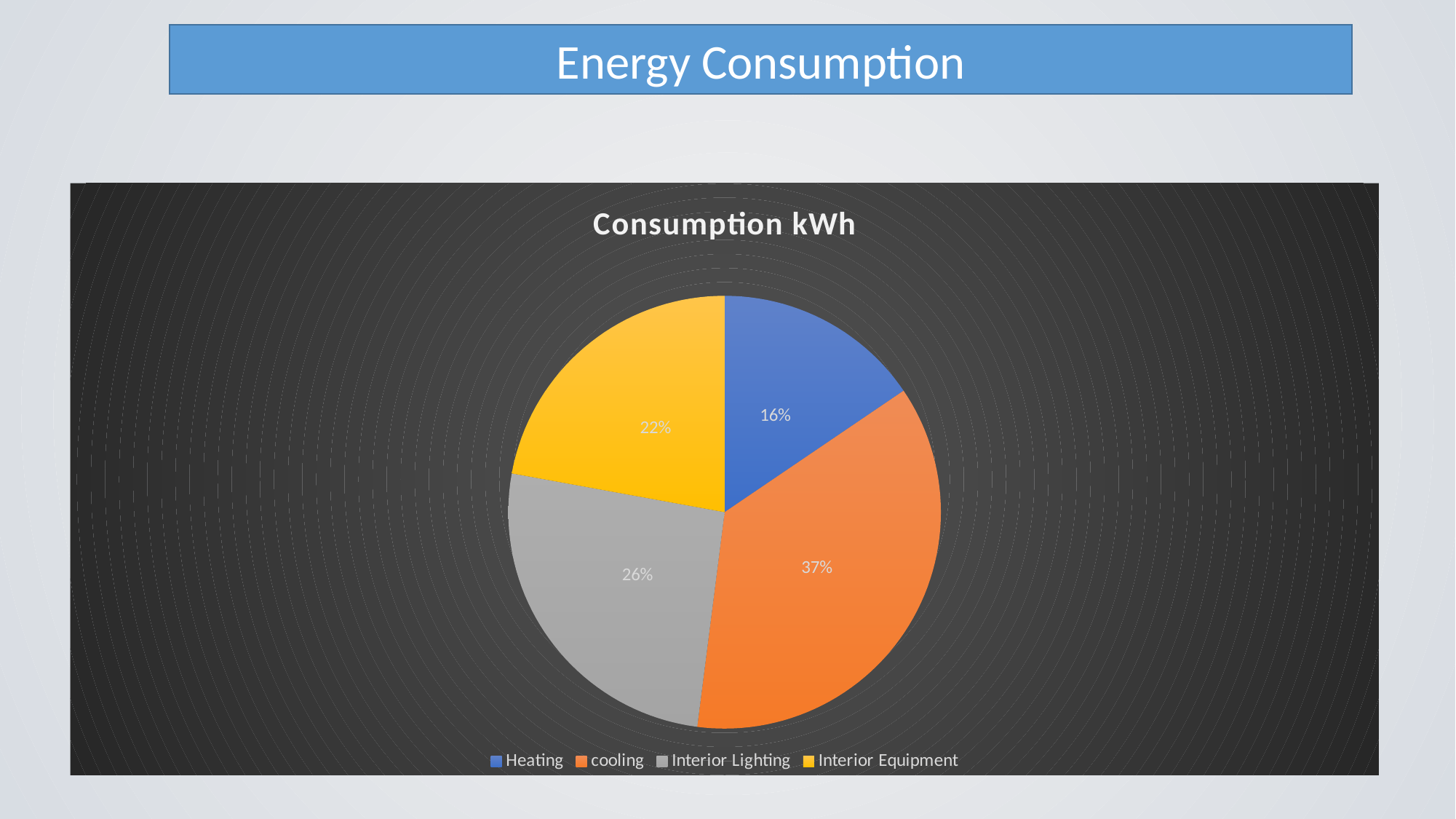
Which colour represents Interior Equipment in the legend? Yellow What is the difference in percentage points between the cooling share and the Heating share? 21 percentage points Which has a larger share, Interior Lighting or Interior Equipment? Interior Lighting What type of chart is shown on the slide? Pie chart Which category has the largest share of the pie? cooling What is the title of the chart? Consumption kWh What share of the pie does Interior Equipment account for? 22% How many categories does the pie chart show? 4 Which category has the smallest share of the pie? Heating What share of the pie does cooling account for? 37% What share of the pie does Interior Lighting account for? 26%